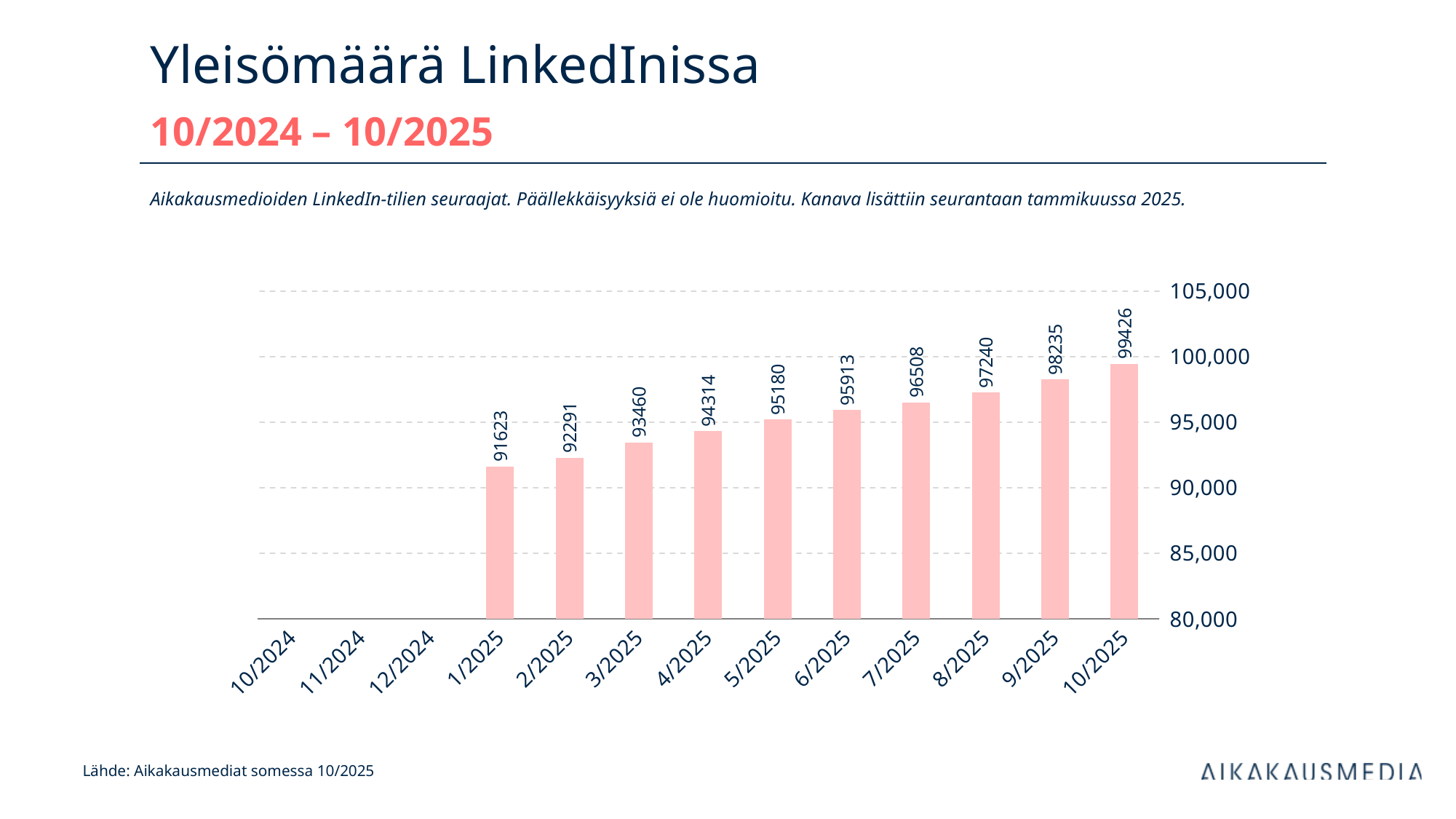
What is the value for 10/2025? 99426 What is the difference between the values for 10/2025 and 1/2025? 7803 How many months have a plotted bar on the chart? 10 What is the difference between the values for 9/2025 and 8/2025? 995 What kind of chart is shown on the slide? bar chart Which month with a plotted bar has the lowest value? 1/2025 What is the value for 1/2025? 91623 Is the value for 6/2025 greater or less than 95,000? greater Which is larger, the value for 3/2025 or the value for 7/2025? 7/2025 What is the value for 5/2025? 95180 Which month has the highest value? 10/2025 Do the values rise or fall from 1/2025 to 10/2025? rise